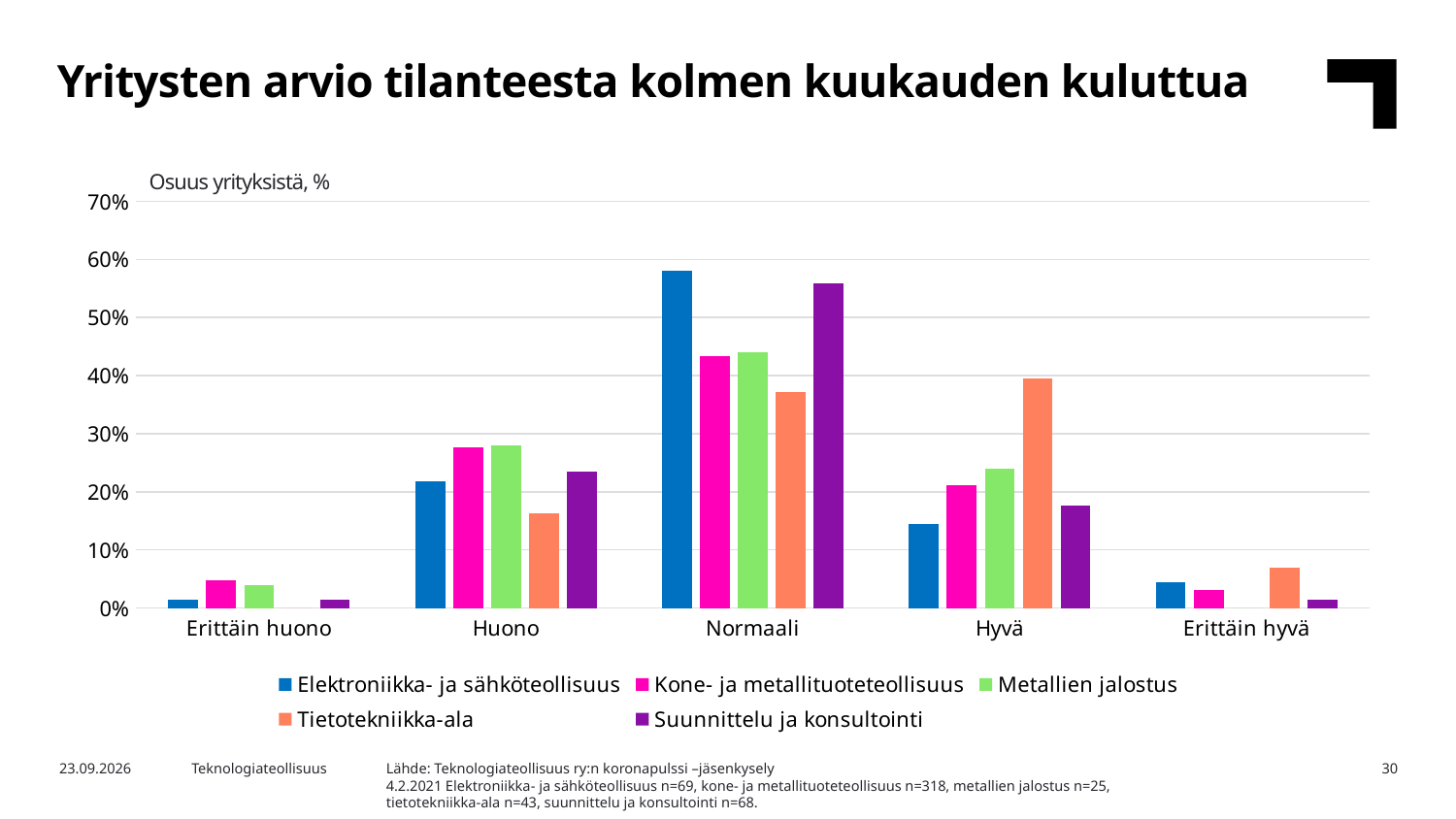
What is the label shown above the y axis of the chart? Osuus yrityksistä, % How many series does the legend list? 5 How many categories are shown on the x axis? 5 In the Normaali category, which series has the lowest value? Tietotekniikka-ala For Elektroniikka- ja sähköteollisuus, which category has the highest value? Normaali Is the value for Tietotekniikka-ala in the Hyvä category greater or less than 30%? greater Is the value for Elektroniikka- ja sähköteollisuus in the Normaali category greater or less than 50%? greater In the Hyvä category, which series has the highest value? Tietotekniikka-ala In the Normaali category, which is larger: Elektroniikka- ja sähköteollisuus or Kone- ja metallituoteteollisuus? Elektroniikka- ja sähköteollisuus In the Hyvä category, which is larger: Tietotekniikka-ala or Elektroniikka- ja sähköteollisuus? Tietotekniikka-ala Is the value for Kone- ja metallituoteteollisuus in the Huono category greater or less than 20%? greater What kind of chart is shown on the slide? bar chart